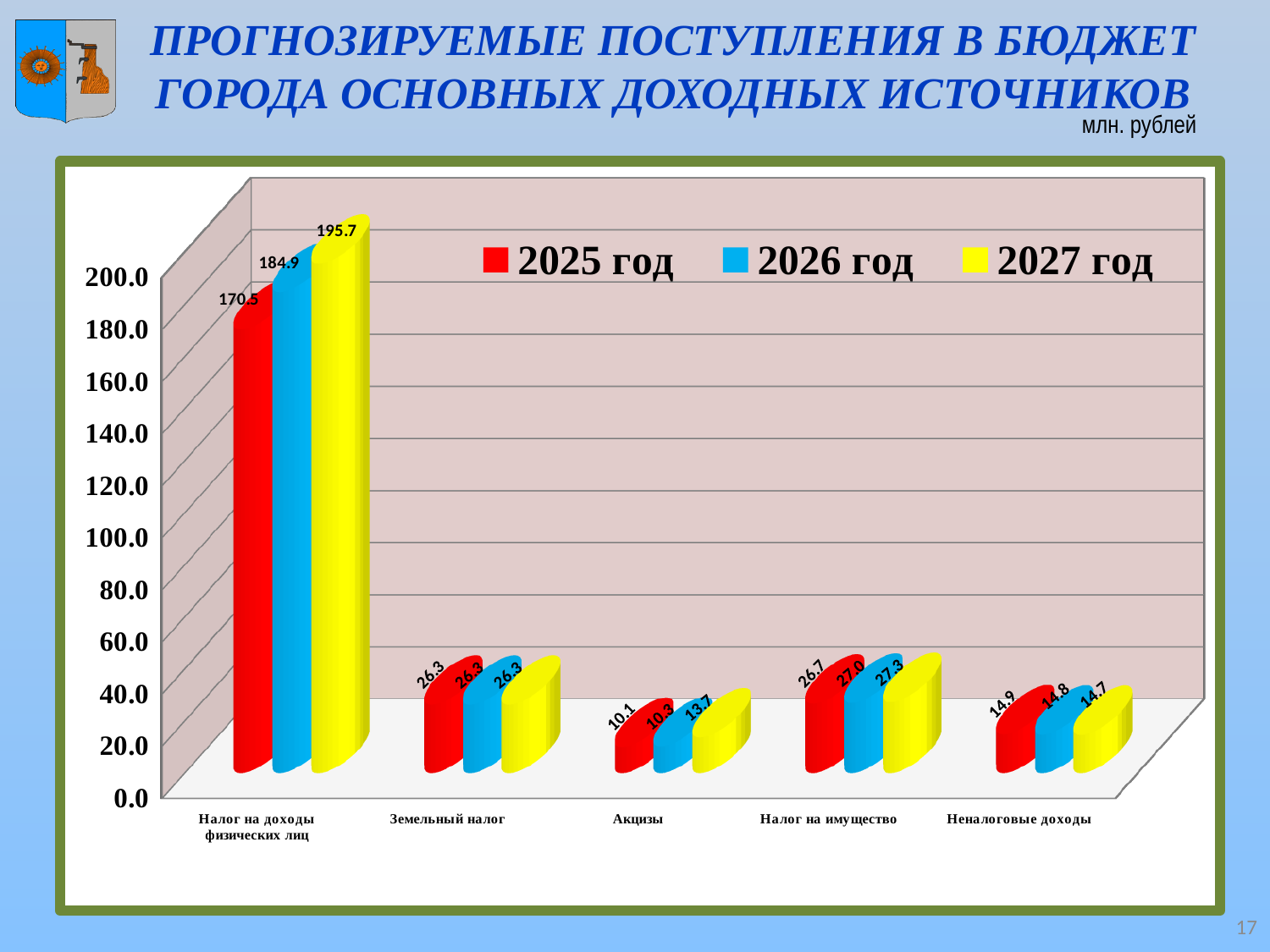
What kind of chart is shown on the slide? Bar chart What is the value for Акцизы in the 2027 год series? 13.7 What is the difference between the 2027 год and 2025 год values for Налог на доходы физических лиц? 25.2 Which colour represents the 2026 год series in the legend? Blue Which is larger for Акцизы: the 2025 год value or the 2027 год value? 2027 год Which category has the highest value in the 2027 год series? Налог на доходы физических лиц How many series does the legend list? 3 What is the value for Неналоговые доходы in the 2027 год series? 14.7 What is the value for Налог на имущество in the 2026 год series? 27.0 How many categories are shown on the x axis? 5 Which category has the lowest value in the 2025 год series? Акцизы What is the value for Налог на доходы физических лиц in the 2025 год series? 170.5